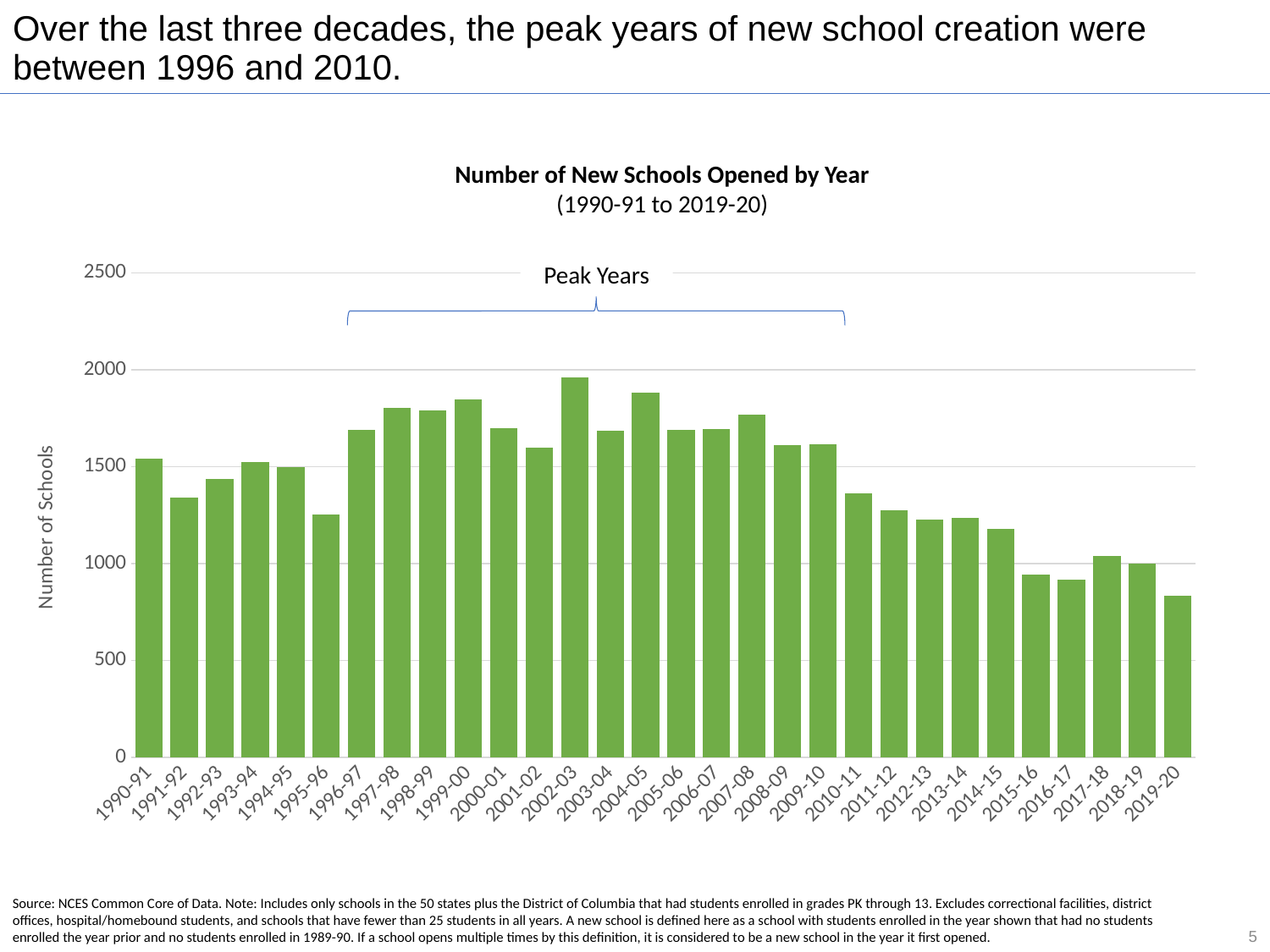
Which has a higher value, 2003-04 or 2004-05? 2004-05 Which school year has the highest number of new schools opened? 2002-03 Is the value for 1995-96 greater or less than 1500? less What type of chart is shown on the slide? Bar chart Is the value for 2002-03 greater or less than 2000? less What is the label on the vertical axis of the chart? Number of Schools Which school year has the lowest number of new schools opened? 2019-20 Do the values generally rise or fall from 2009-10 to 2019-20? fall Is the value for 2015-16 greater or less than 1000? less How many school years (bars) are plotted in the chart? 30 What is the title of the chart? Number of New Schools Opened by Year (1990-91 to 2019-20)